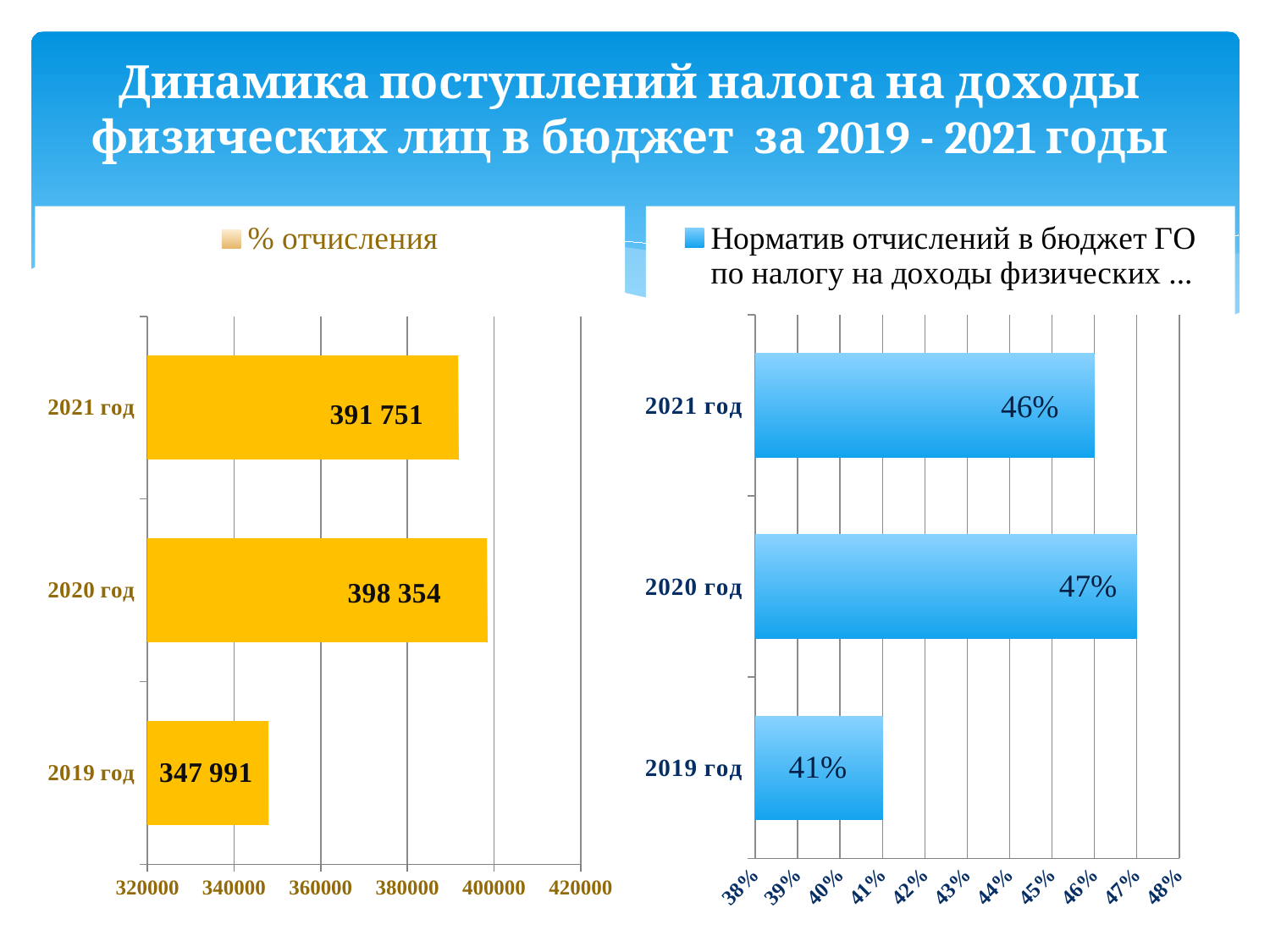
On the left chart, which year has the lowest value? 2019 год On the right chart, what is the difference between the values for 2021 год and 2019 год? 5% How many categories does the right chart show? 3 On the left chart, what is the value for 2019 год? 347 991 On the right chart, which year has the lowest value? 2019 год On the right chart, what is the value for 2019 год? 41% On the left chart, what is the difference between the values for 2020 год and 2021 год? 6 603 What kind of chart is the left chart? bar chart On the right chart, what is the value for 2020 год? 47% On the left chart, what is the value for 2021 год? 391 751 On the left chart, is the value for 2019 год greater or less than 360000? less On the left chart, which year has the highest value? 2020 год